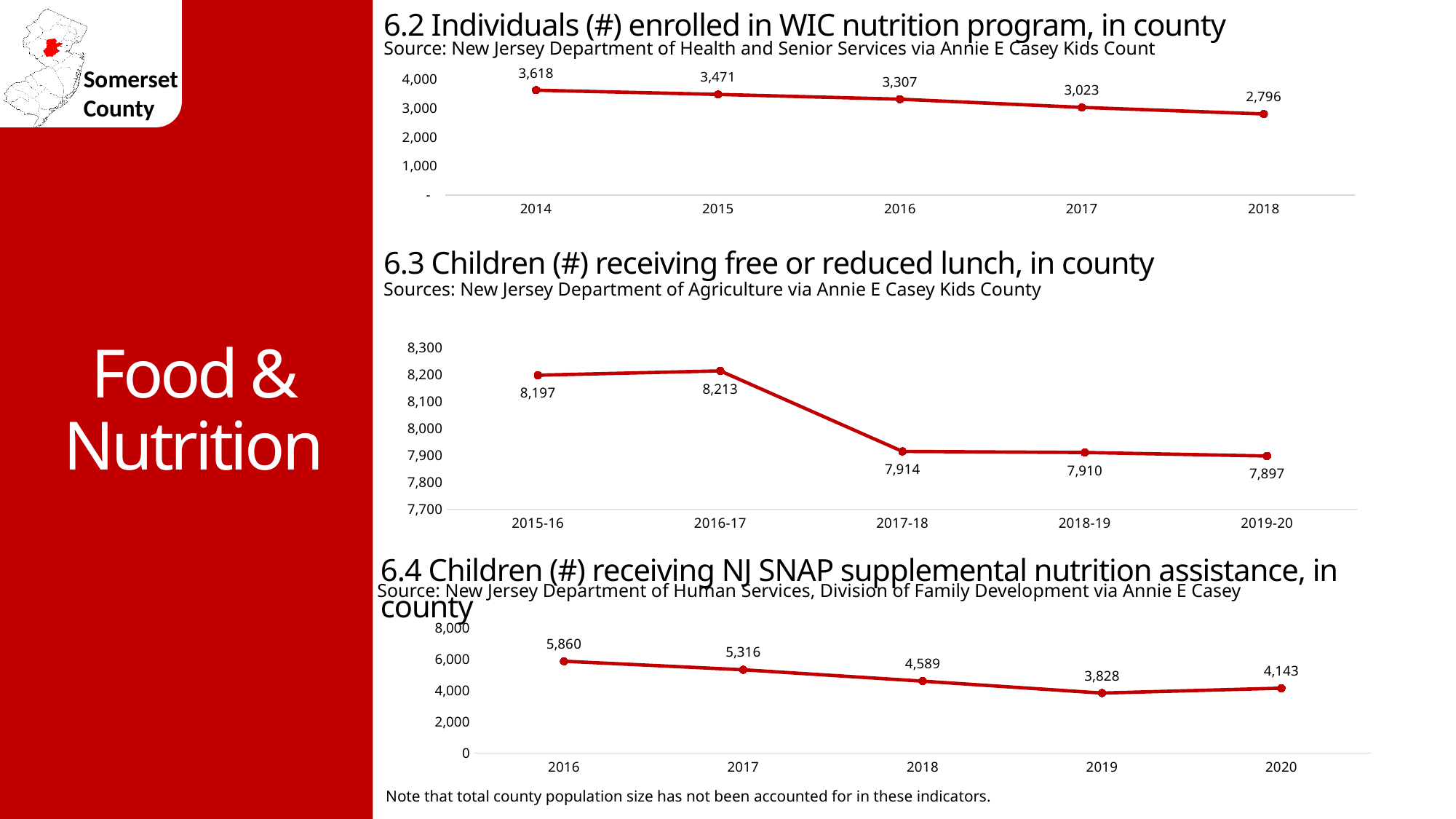
In the chart '6.4 Children (#) receiving NJ SNAP supplemental nutrition assistance, in county', what is the difference between the 2016 and 2017 values? 544 In the chart '6.2 Individuals (#) enrolled in WIC nutrition program, in county', do the values rise or fall from 2014 to 2018? fall In the chart '6.3 Children (#) receiving free or reduced lunch, in county', what is the value for 2016-17? 8,213 In the chart '6.2 Individuals (#) enrolled in WIC nutrition program, in county', which year has the lowest value? 2018 What kind of chart is used for '6.4 Children (#) receiving NJ SNAP supplemental nutrition assistance, in county'? line chart In the chart '6.4 Children (#) receiving NJ SNAP supplemental nutrition assistance, in county', which is larger, the value for 2018 or the value for 2020? 2018 In the chart '6.3 Children (#) receiving free or reduced lunch, in county', what is the difference between the 2016-17 and 2017-18 values? 299 In the chart '6.4 Children (#) receiving NJ SNAP supplemental nutrition assistance, in county', what is the value for 2019? 3,828 In the chart '6.2 Individuals (#) enrolled in WIC nutrition program, in county', what is the difference between the 2014 and 2018 values? 822 In the chart '6.2 Individuals (#) enrolled in WIC nutrition program, in county', what is the value for 2014? 3,618 In the chart '6.3 Children (#) receiving free or reduced lunch, in county', which school year has the highest value? 2016-17 In the chart '6.3 Children (#) receiving free or reduced lunch, in county', how many data points are plotted? 5